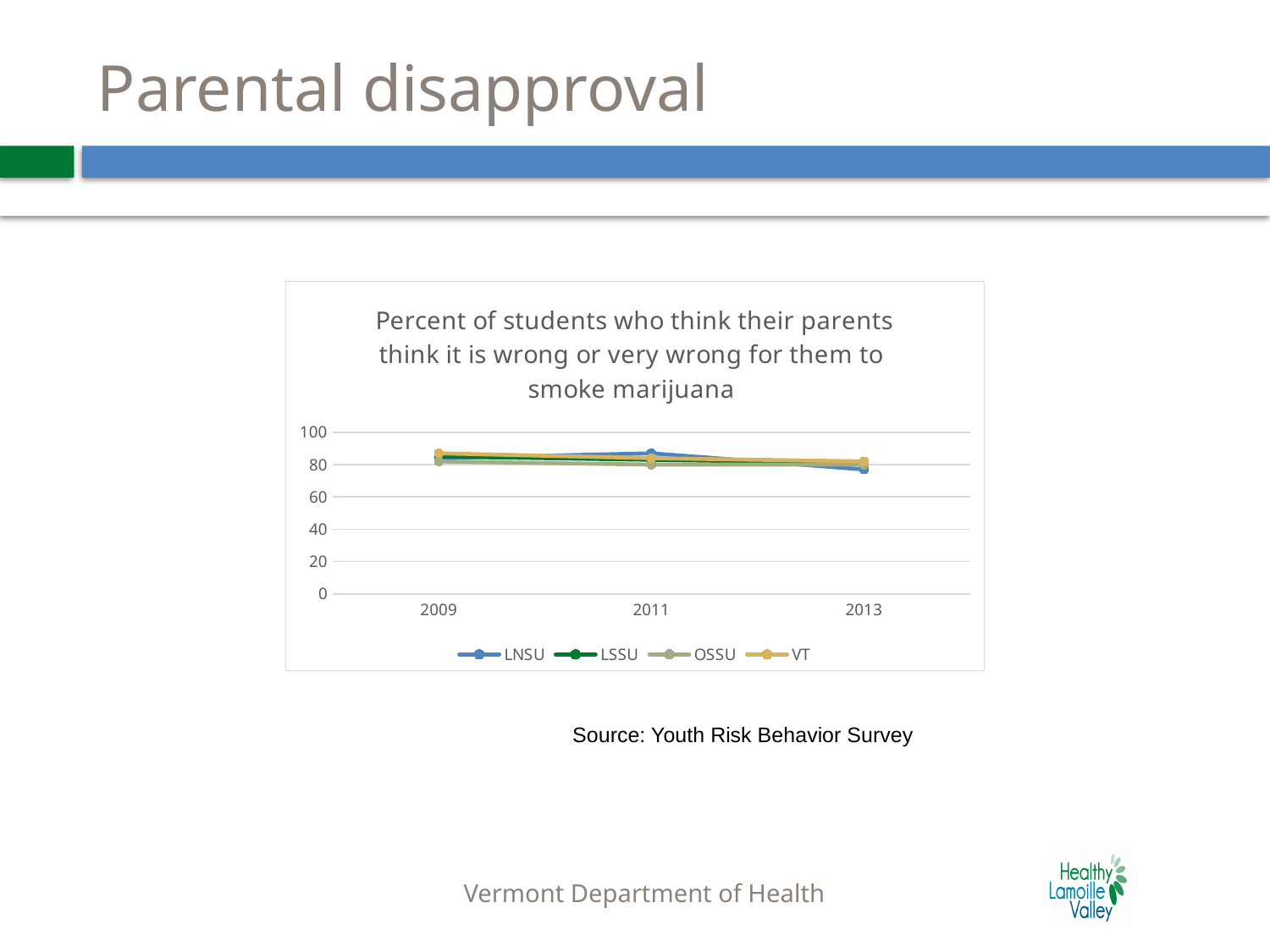
How many series does the legend list? 4 Is the value for LSSU in 2013 greater or less than 40? greater Is the value for LNSU in 2013 greater or less than 60? greater How many years are shown on the x axis? 3 What is the title of the chart? Percent of students who think their parents think it is wrong or very wrong for them to smoke marijuana What is the highest value shown on the y axis? 100 Which year is the first shown on the x axis? 2009 Which series are listed in the legend? LNSU, LSSU, OSSU, VT Is the value for OSSU in 2011 greater or less than 60? greater Does the LNSU line rise or fall from 2011 to 2013? fall What kind of chart is shown on the slide? line chart